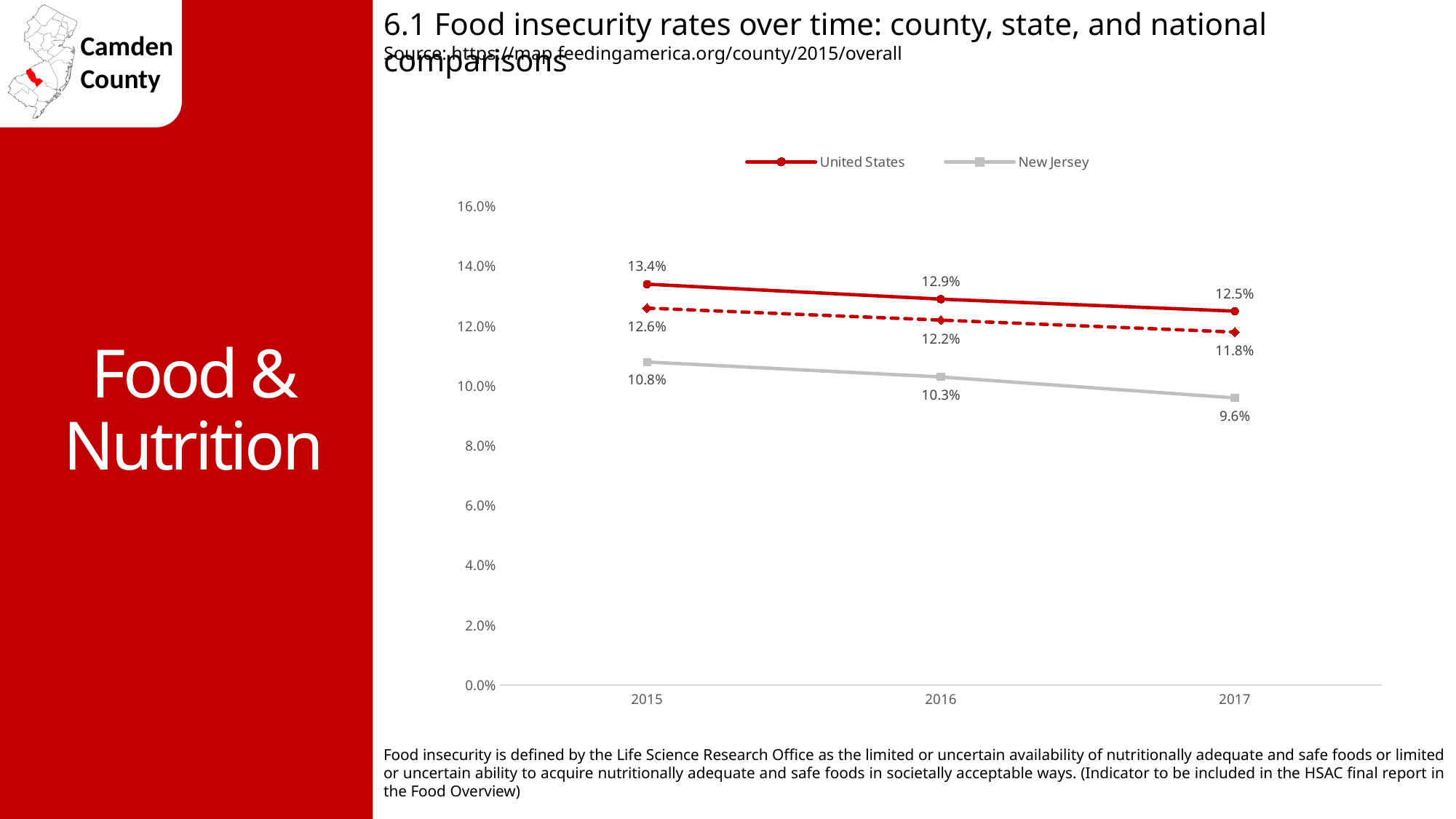
In which year was the United States food insecurity rate lowest? 2017 What is the food insecurity rate for the United States in 2015? 13.4% What is the food insecurity rate for the United States in 2016? 12.9% What kind of chart is shown on the slide? Line chart How many years are shown on the x axis of the chart? 3 What is the difference between the United States and New Jersey food insecurity rates in 2017? 2.9 percentage points How many series does the chart legend list? 2 What is the food insecurity rate for New Jersey in 2017? 9.6% What is the food insecurity rate for New Jersey in 2015? 10.8% Does the New Jersey food insecurity rate rise or fall from 2015 to 2017? It falls By how many percentage points did the United States food insecurity rate fall from 2015 to 2017? 0.9 percentage points In 2016, which had the higher food insecurity rate, the United States or New Jersey? United States